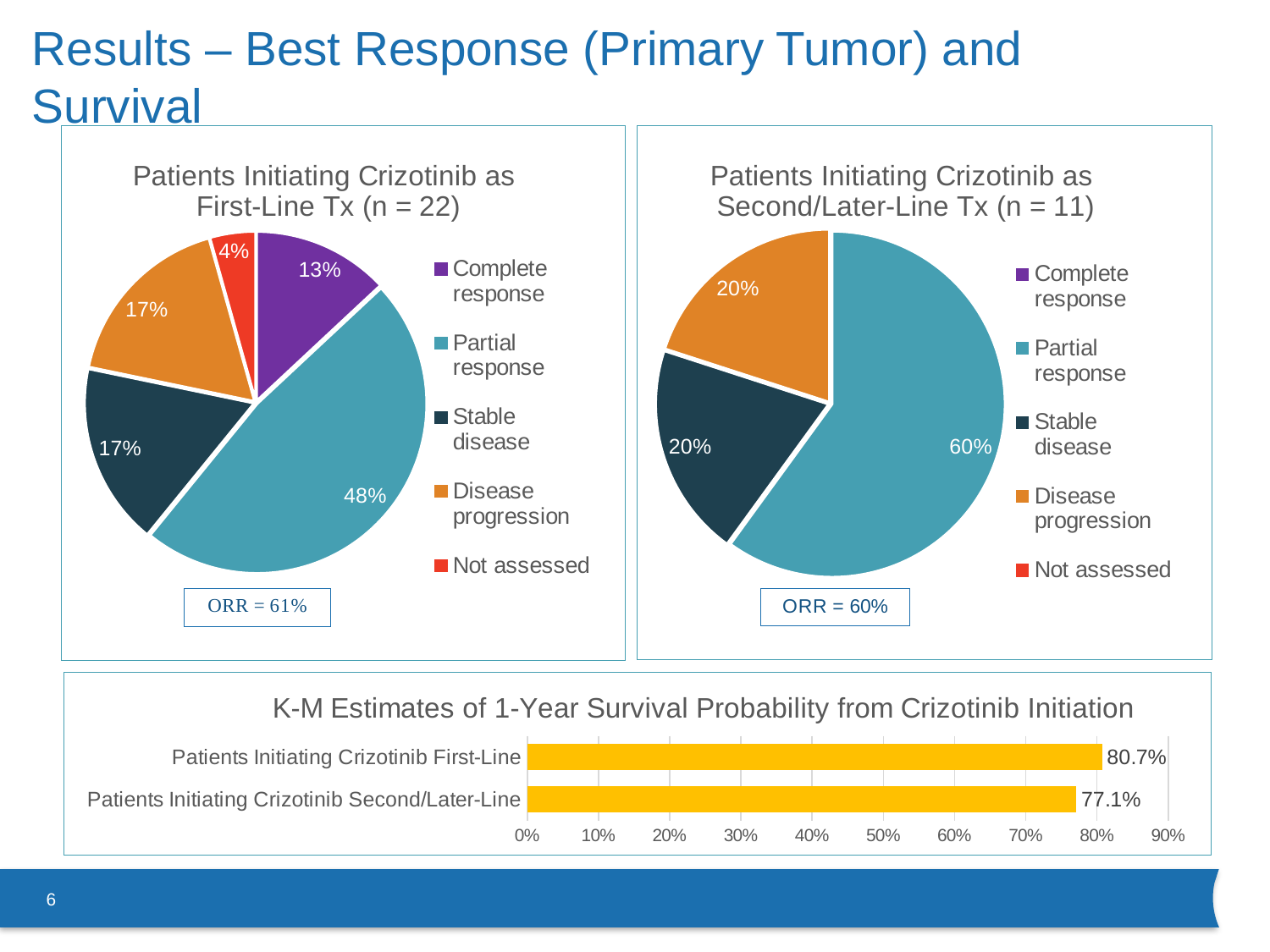
In the pie chart titled "Patients Initiating Crizotinib as First-Line Tx (n = 22)", which category has the smallest slice? Not assessed In the pie chart titled "Patients Initiating Crizotinib as Second/Later-Line Tx (n = 11)", what share is Partial response? 60% In the chart titled "K-M Estimates of 1-Year Survival Probability from Crizotinib Initiation", what is the value for Patients Initiating Crizotinib First-Line? 80.7% In the pie chart titled "Patients Initiating Crizotinib as First-Line Tx (n = 22)", what is the difference between the Partial response and Complete response shares? 35% How many entries does the legend of the pie chart titled "Patients Initiating Crizotinib as Second/Later-Line Tx (n = 11)" list? 5 In the pie chart titled "Patients Initiating Crizotinib as Second/Later-Line Tx (n = 11)", what share is Stable disease? 20% In the pie chart titled "Patients Initiating Crizotinib as First-Line Tx (n = 22)", what share is Complete response? 13% In the pie chart titled "Patients Initiating Crizotinib as First-Line Tx (n = 22)", which category has the largest slice? Partial response What kind of chart is the one titled "K-M Estimates of 1-Year Survival Probability from Crizotinib Initiation"? Bar chart In the pie chart titled "Patients Initiating Crizotinib as Second/Later-Line Tx (n = 11)", which category has the largest slice? Partial response In the chart titled "K-M Estimates of 1-Year Survival Probability from Crizotinib Initiation", what is the difference between the First-Line and Second/Later-Line values? 3.6% In the pie chart titled "Patients Initiating Crizotinib as First-Line Tx (n = 22)", what share is Partial response? 48%